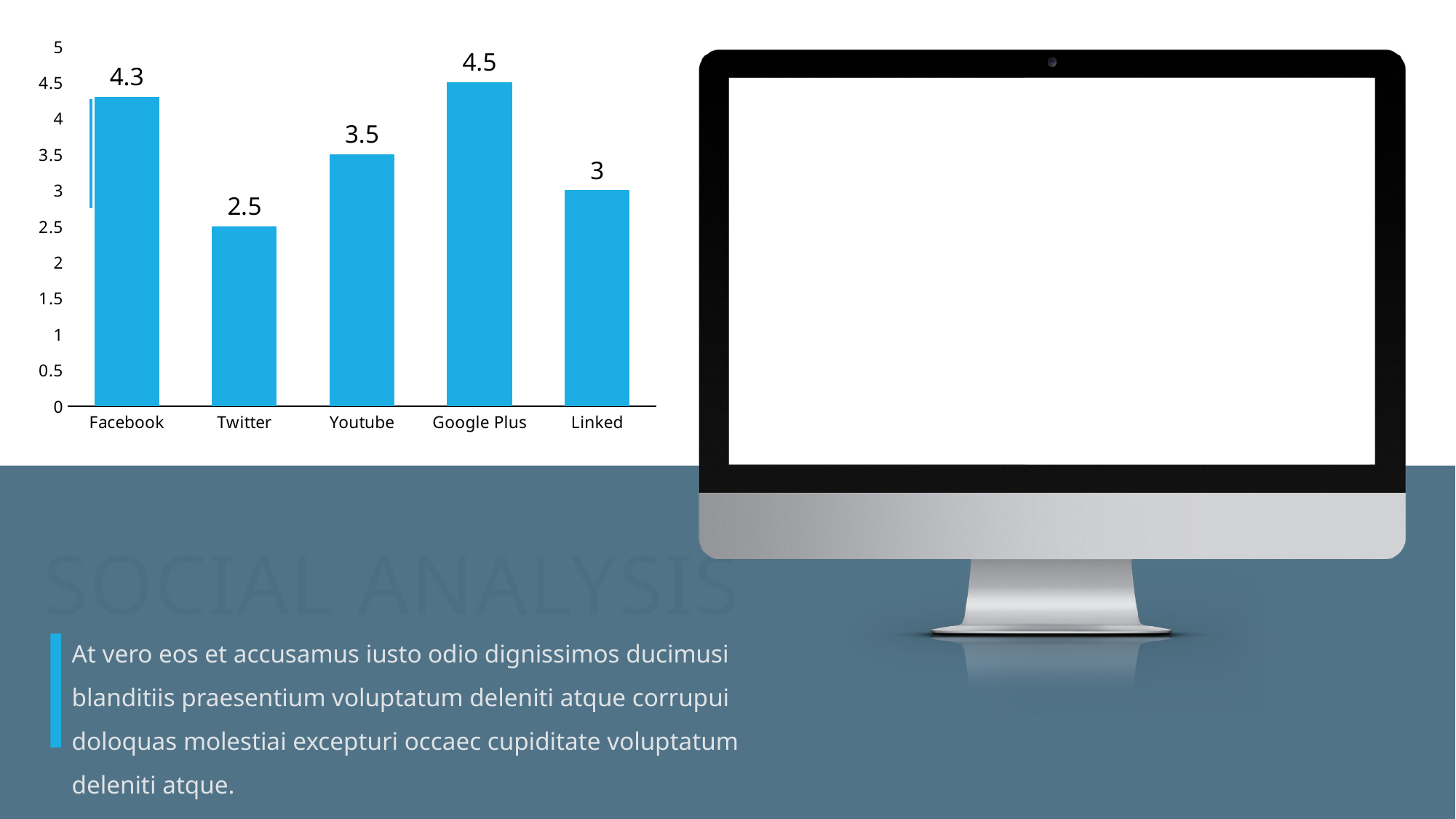
Which is larger, the value for Youtube or the value for Linked? Youtube Which category has the highest value? Google Plus What is the value for Google Plus? 4.5 What is the value for Youtube? 3.5 How many categories are shown on the x axis? 5 What kind of chart is shown on the slide? Bar chart What is the value for Twitter? 2.5 Which category has the lowest value? Twitter What is the value for Linked? 3 What is the value for Facebook? 4.3 What is the difference between the values for Google Plus and Twitter? 2 What colour are the bars in the chart? Blue